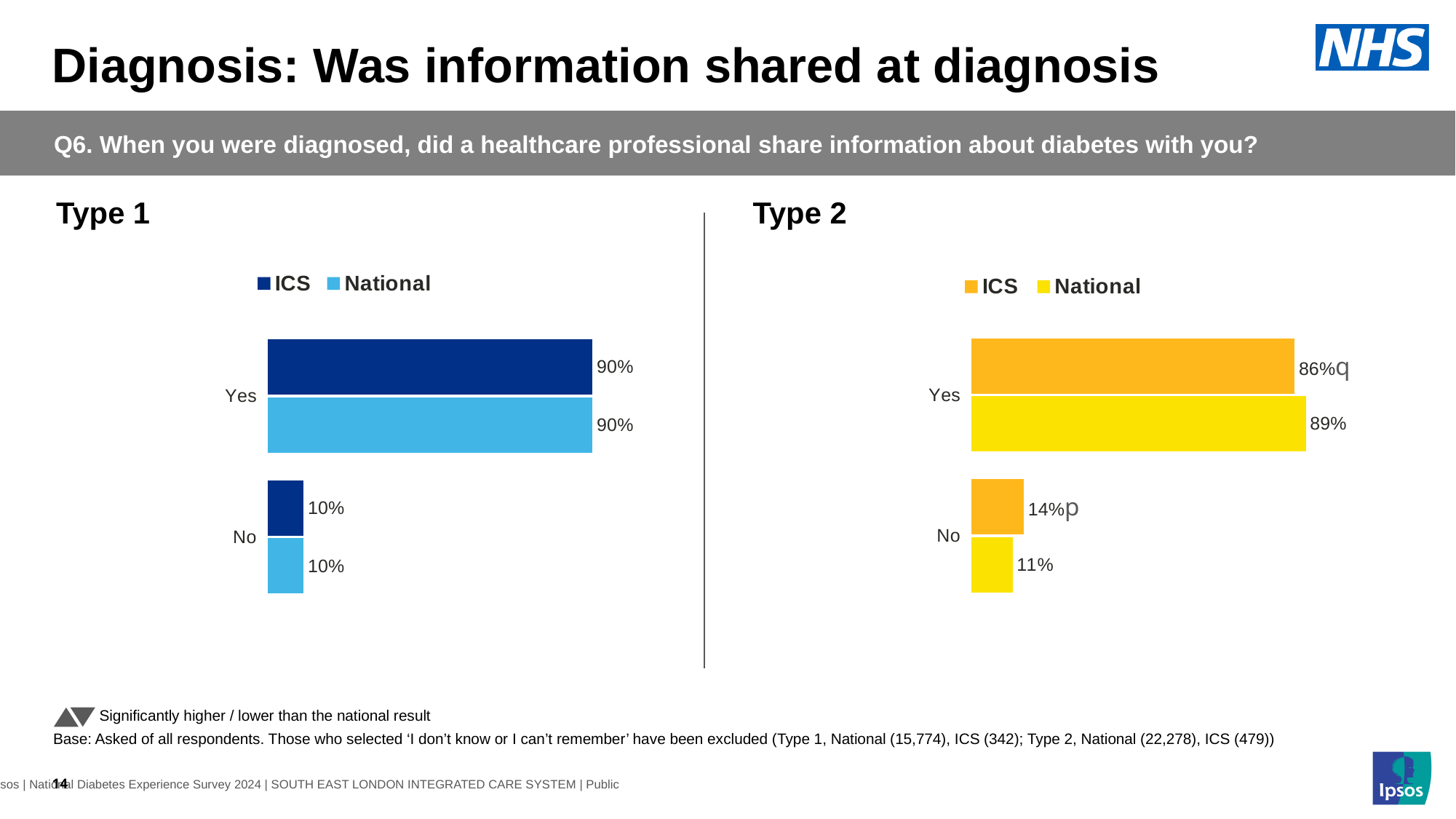
In the Type 2 chart, what is the difference between the ICS and National values for No? 3% In the Type 1 chart, what is the ICS value for Yes? 90% How many series does the legend of the Type 1 chart list? 2 In the Type 2 chart, what is the ICS value for Yes? 86% In the Type 2 chart, what is the ICS value for No? 14% What kind of chart is the Type 2 chart? Bar chart In the Type 2 chart, what is the National value for No? 11% In the Type 2 chart, which category has the lowest National value? No In the Type 2 chart, which is larger for Yes, the ICS value or the National value? National In the Type 1 chart, what is the National value for No? 10% In the Type 2 chart, what is the National value for Yes? 89% In the Type 1 chart, which category has the highest ICS value? Yes